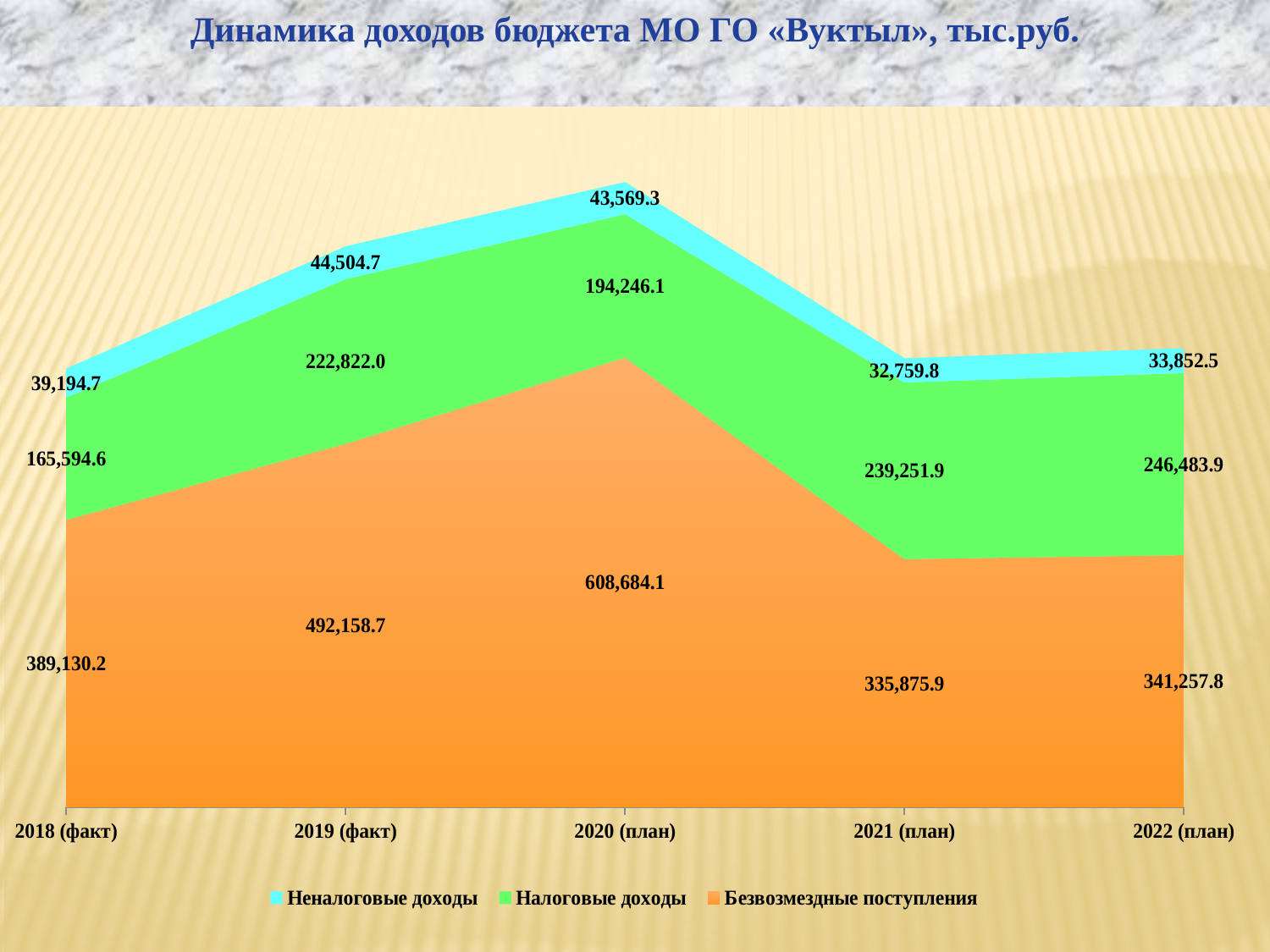
How many periods are shown on the x axis? 5 In which period is Налоговые доходы lowest? 2018 (факт) What is the value of Безвозмездные поступления for 2020 (план)? 608,684.1 How many series does the legend list? 3 What is the total of all three series for 2018 (факт)? 593,919.5 What is the value of Налоговые доходы for 2019 (факт)? 222,822.0 Which series is shown in orange in the legend? Безвозмездные поступления What is the value of Неналоговые доходы for 2021 (план)? 32,759.8 What type of chart is shown on the slide? Stacked area chart Which is larger: Неналоговые доходы in 2019 (факт) or in 2022 (план)? 2019 (факт) What is the difference between Безвозмездные поступления in 2020 (план) and 2021 (план)? 272,808.2 In which period is Безвозмездные поступления highest? 2020 (план)